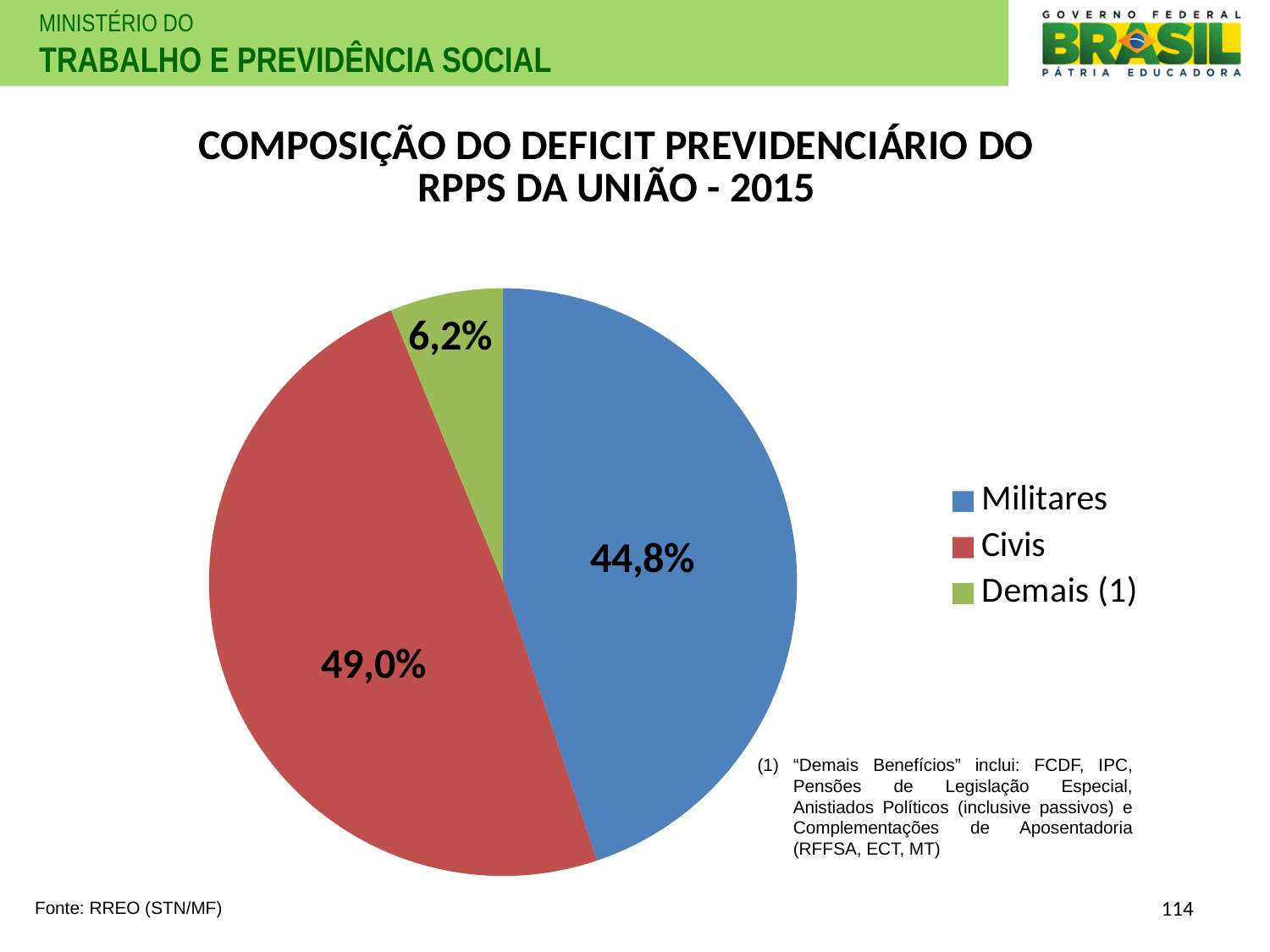
What is the difference in percentage points between the Civis and Militares slices? 4,2 Which category has the smallest slice of the pie? Demais (1) What share of the pie does Civis represent? 49,0% What is the difference in percentage points between the Militares and Demais (1) slices? 38,6 What share of the pie does Militares represent? 44,8% What is the title of the chart? COMPOSIÇÃO DO DEFICIT PREVIDENCIÁRIO DO RPPS DA UNIÃO - 2015 Which is larger, the Militares slice or the Demais (1) slice? Militares What kind of chart is shown on the slide? Pie chart What share of the pie does Demais (1) represent? 6,2% How many slices does the pie chart have? 3 Which category has the largest slice of the pie? Civis Which colour represents Civis in the legend? Red